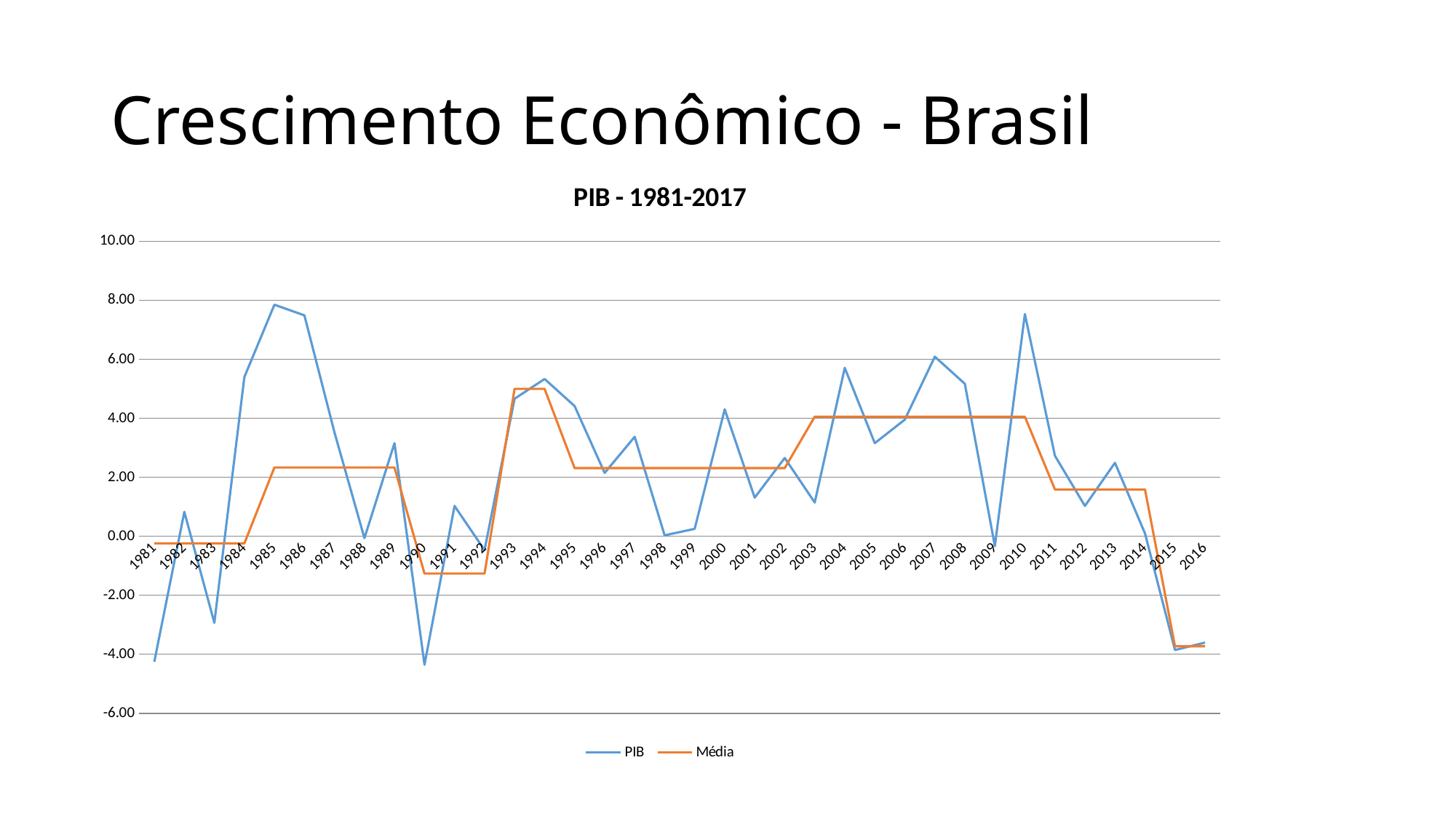
Is the Média value for 2012 greater or less than 2.00? less Is the PIB value for 1990 greater or less than -2.00? less Which series is drawn in orange? Média Is the PIB value for 1985 greater or less than 6.00? greater How many series does the legend list? 2 Does the PIB line rise or fall from 2010 to 2015? fall Which is larger, the PIB value for 2010 or the PIB value for 2011? 2010 What kind of chart is shown on the slide? line chart What is the title of the chart? PIB - 1981-2017 How many years are shown on the x axis? 36